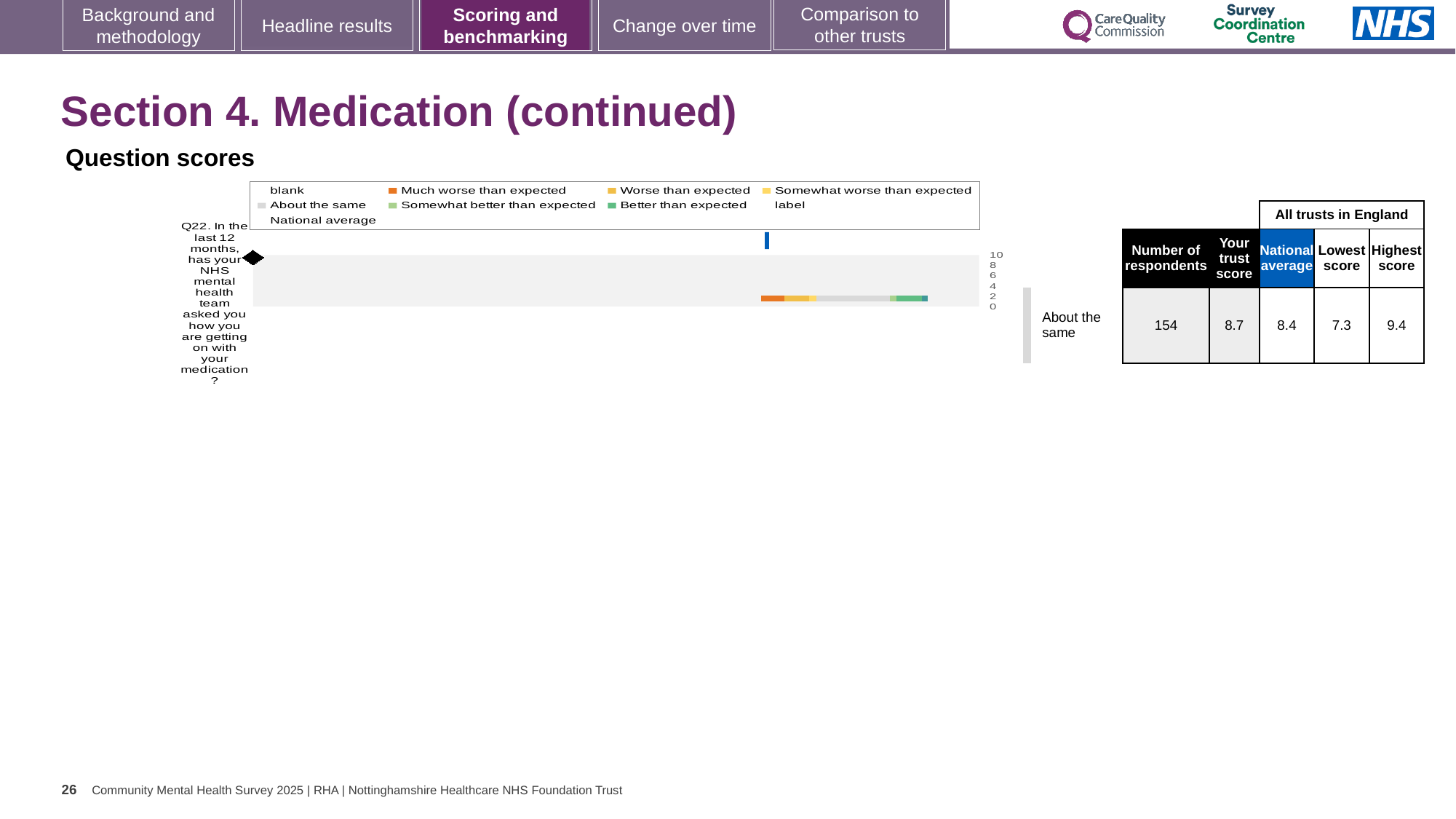
What is the trust's score for Q22? 8.7 What is the difference between the highest and lowest trust scores in England for Q22? 2.1 Which is larger for Q22, the trust score or the national average? trust score Which benchmark category is Q22 placed in? About the same What kind of chart is shown under 'Question scores'? bar chart What is the lowest score among all trusts in England for Q22? 7.3 Which question is plotted on the chart? Q22. In the last 12 months, has your NHS mental health team asked you how you are getting on with your medication? What is the highest value shown on the chart's score axis? 10 How many respondents answered Q22? 154 How many questions are plotted on the chart? 1 What is the national average score for Q22? 8.4 What is the highest score among all trusts in England for Q22? 9.4